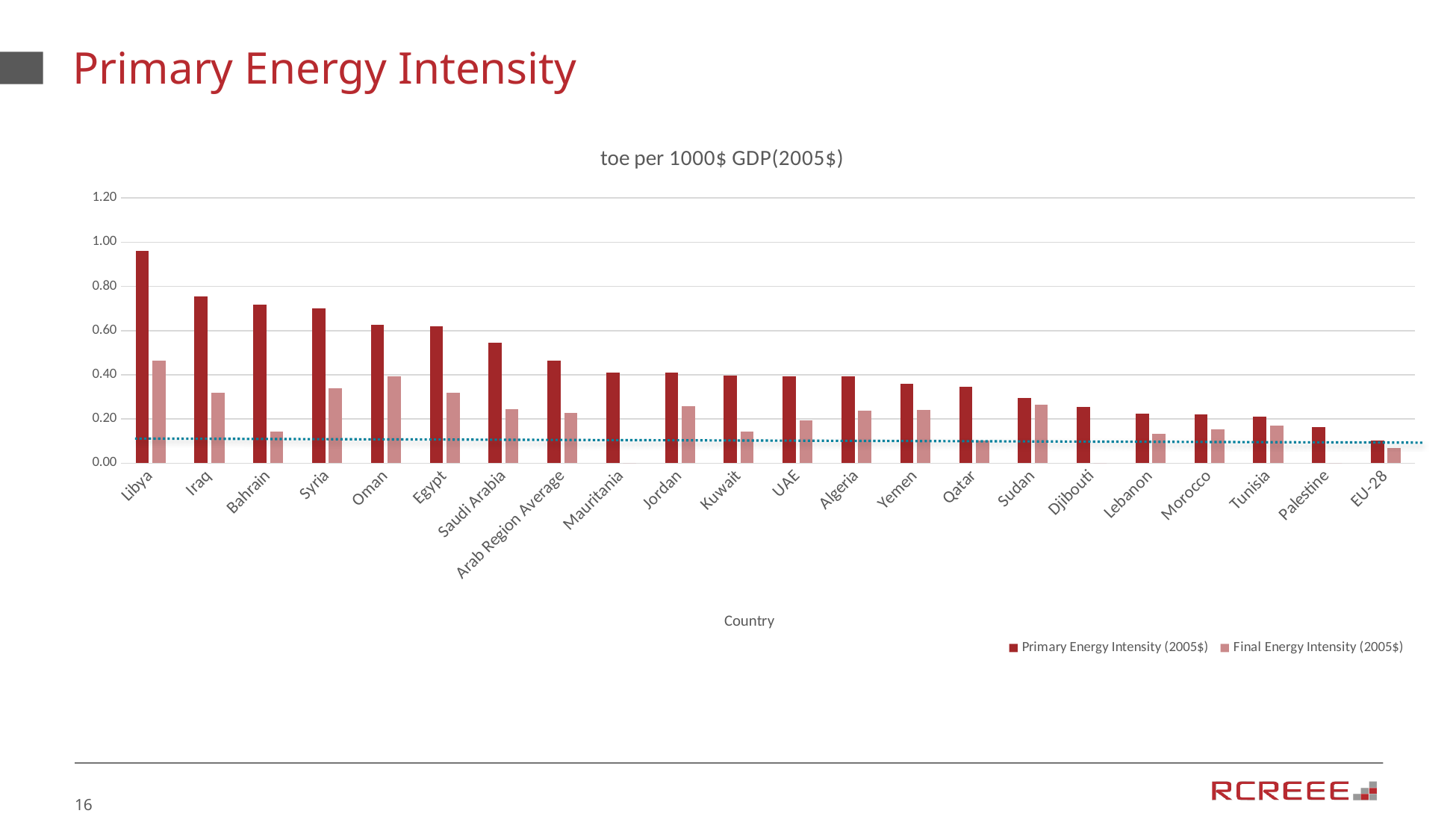
Which country has the highest Primary Energy Intensity (2005$)? Libya How many series does the legend list? 2 Is the Primary Energy Intensity (2005$) value for Libya greater or less than 0.80? greater Which is larger, the Primary Energy Intensity (2005$) for Libya or for Iraq? Libya Which country has the highest Final Energy Intensity (2005$)? Libya Which category has the lowest Primary Energy Intensity (2005$)? EU-28 Is the Primary Energy Intensity (2005$) value for Saudi Arabia greater or less than 0.60? less Do the Primary Energy Intensity (2005$) values rise or fall moving from left to right along the x axis? fall Is the Final Energy Intensity (2005$) value for Bahrain greater or less than 0.20? less What kind of chart is shown on the slide? bar chart What is the title shown above the chart? toe per 1000$ GDP(2005$) How many countries/categories are shown on the x axis? 22